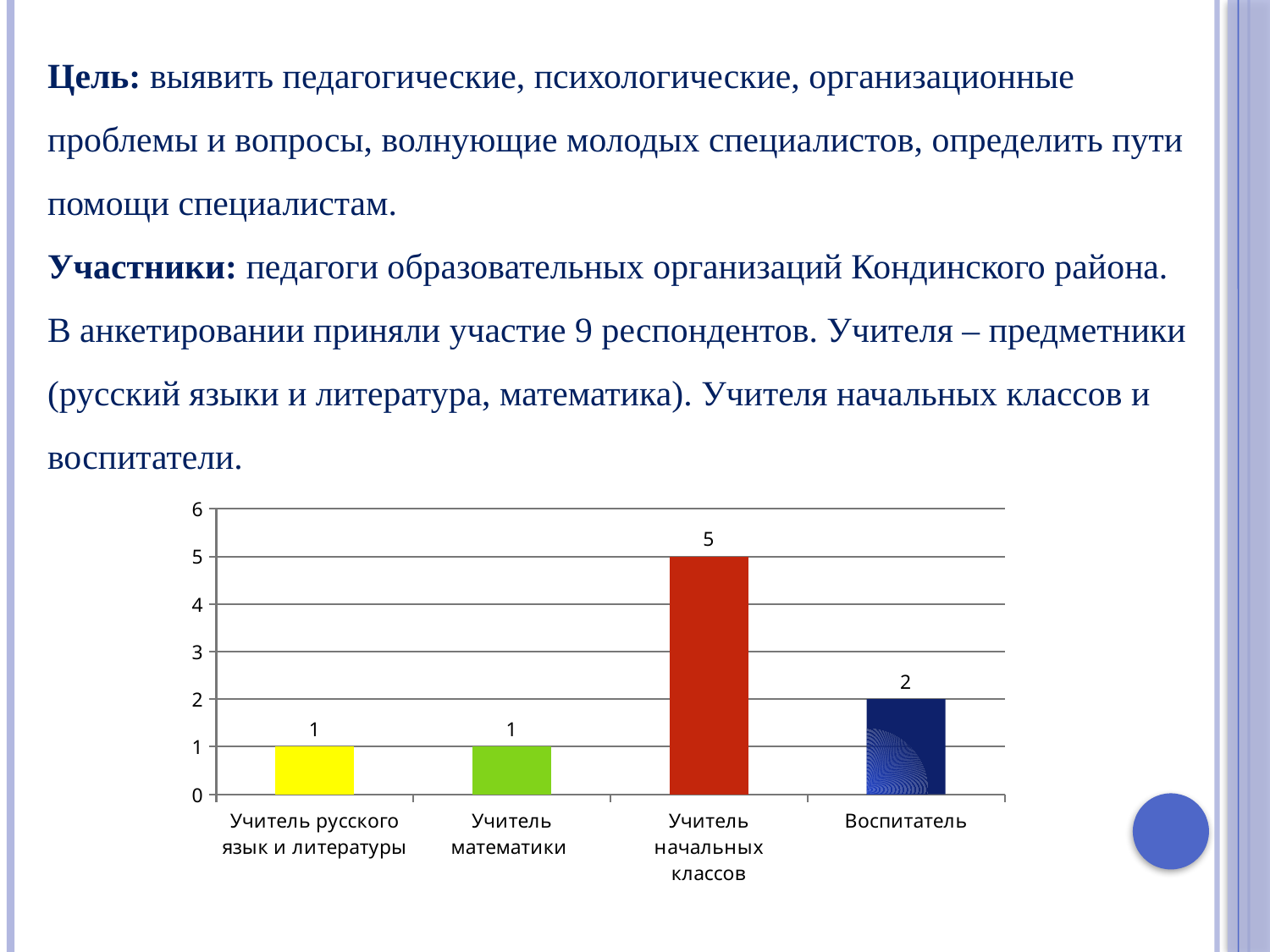
What is the total of all four bar values in the chart? 9 What is the value for Учитель русского язык и литературы? 1 Is the value for Учитель начальных классов greater or less than 4? greater What is the value for Учитель математики? 1 What colour is the bar for Учитель начальных классов? red Which is larger, the value for Воспитатель or the value for Учитель математики? Воспитатель What is the value for Воспитатель? 2 How many categories are shown on the x axis of the chart? 4 Which category has the highest value? Учитель начальных классов What is the value for Учитель начальных классов? 5 What is the difference between the values for Учитель начальных классов and Воспитатель? 3 What kind of chart is shown on the slide? bar chart